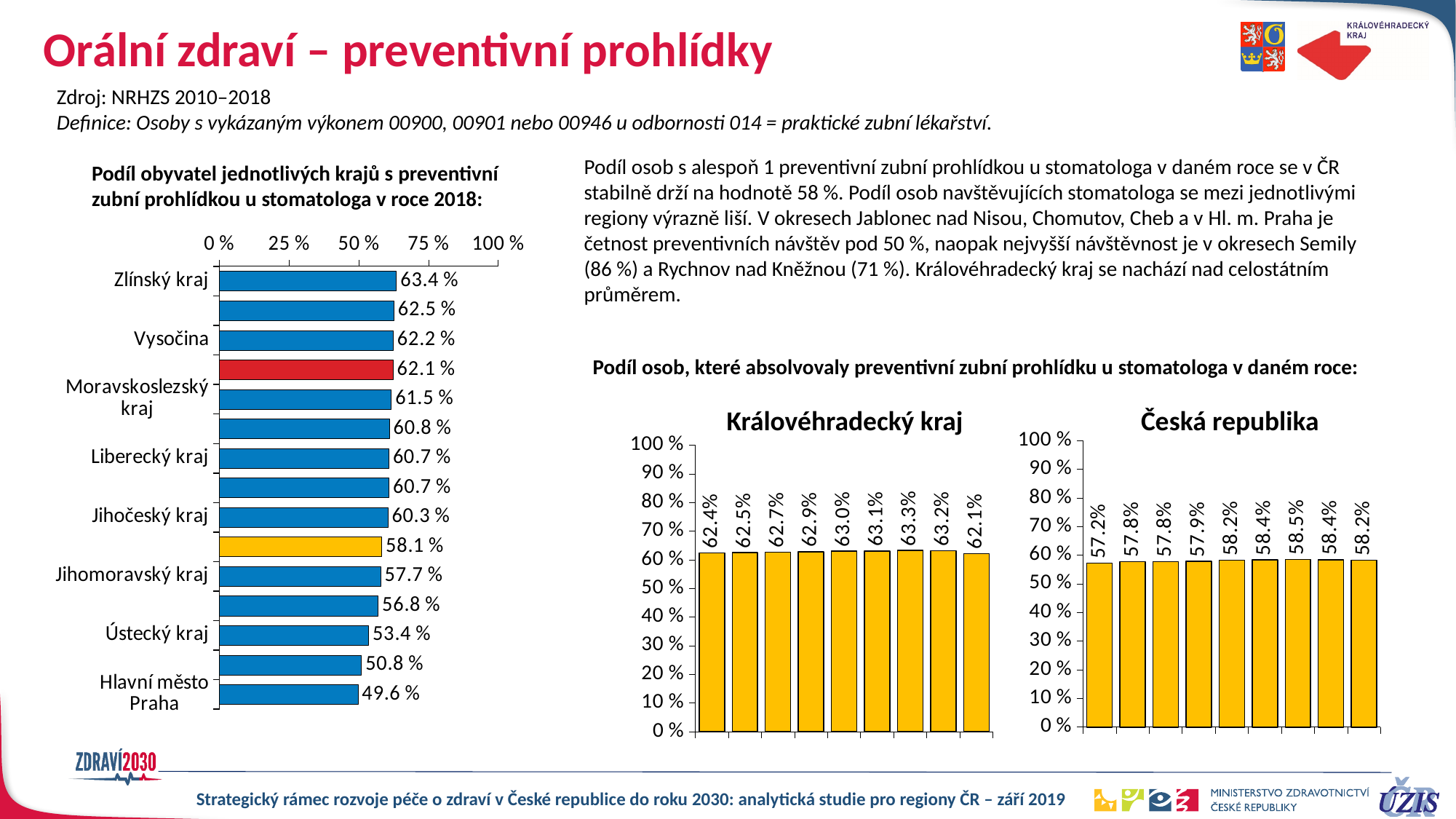
In the 'Královéhradecký kraj' chart, what is the highest value shown? 63.3% In the chart 'Podíl obyvatel jednotlivých krajů s preventivní zubní prohlídkou u stomatologa v roce 2018', which region has the lowest value? Hlavní město Praha In the chart 'Podíl obyvatel jednotlivých krajů s preventivní zubní prohlídkou u stomatologa v roce 2018', which is larger: Vysočina or Jihočeský kraj? Vysočina In the chart 'Podíl obyvatel jednotlivých krajů s preventivní zubní prohlídkou u stomatologa v roce 2018', which labelled region has the highest value? Zlínský kraj In the chart 'Podíl obyvatel jednotlivých krajů s preventivní zubní prohlídkou u stomatologa v roce 2018', what is the difference between Zlínský kraj and Hlavní město Praha? 13.8 % In the chart 'Podíl obyvatel jednotlivých krajů s preventivní zubní prohlídkou u stomatologa v roce 2018', what is the value for Ústecký kraj? 53.4 % In the chart 'Podíl obyvatel jednotlivých krajů s preventivní zubní prohlídkou u stomatologa v roce 2018', how many bars are plotted? 15 In the chart 'Podíl obyvatel jednotlivých krajů s preventivní zubní prohlídkou u stomatologa v roce 2018', what is the value for Zlínský kraj? 63.4 % In the 'Česká republika' chart, what is the value of the first (leftmost) bar? 57.2% In the chart 'Podíl obyvatel jednotlivých krajů s preventivní zubní prohlídkou u stomatologa v roce 2018', what is the value for Hlavní město Praha? 49.6 % In the 'Česká republika' chart, how many bars are plotted? 9 What type of chart is 'Podíl obyvatel jednotlivých krajů s preventivní zubní prohlídkou u stomatologa v roce 2018'? Bar chart